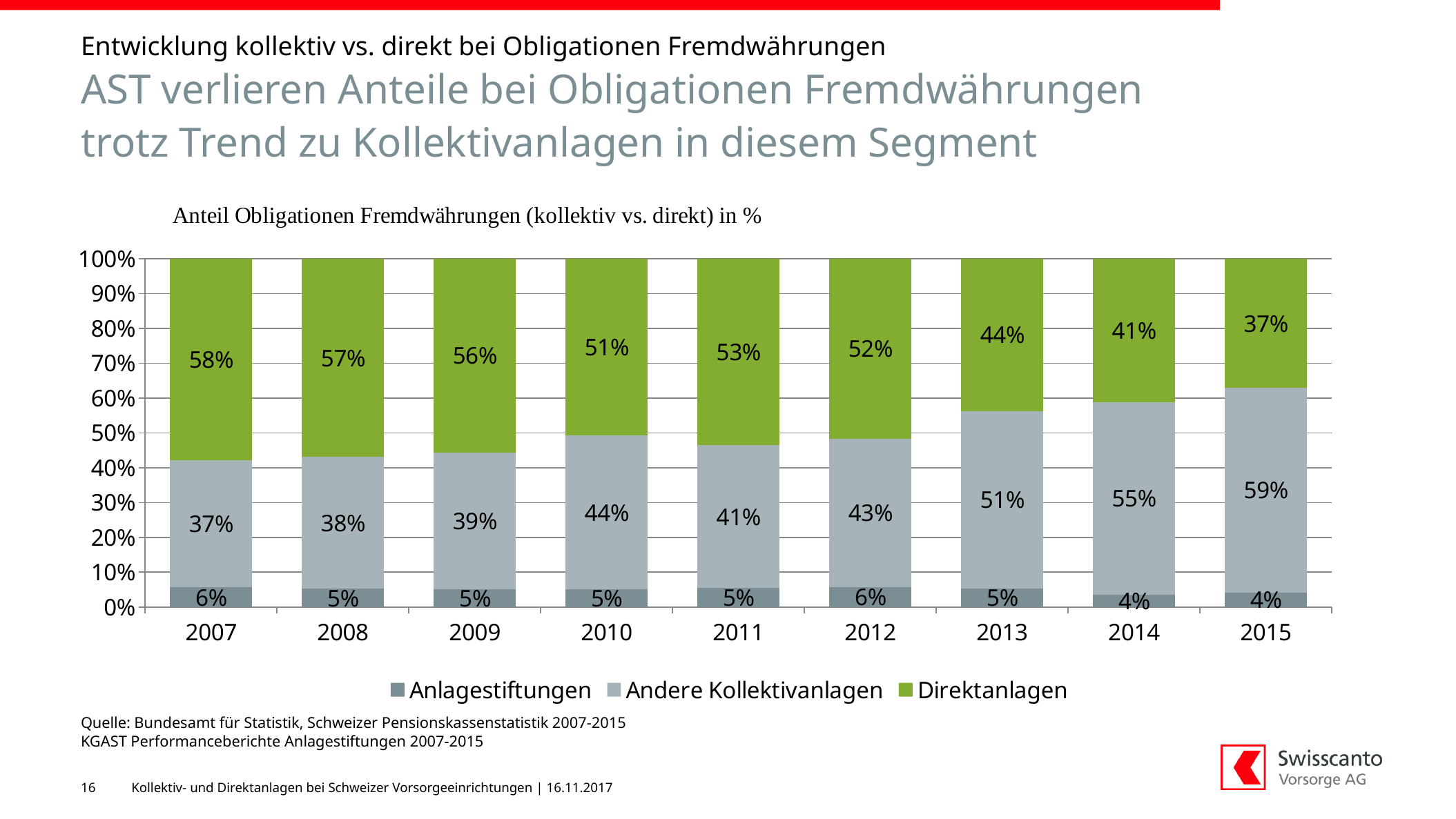
Does the Direktanlagen share rise or fall from 2007 to 2015? Fall What is the value for Andere Kollektivanlagen in 2014? 55% What is the value for Direktanlagen in 2010? 51% What is the difference between the Direktanlagen share in 2007 and in 2015? 21 percentage points In 2013, which is larger: Andere Kollektivanlagen or Direktanlagen? Andere Kollektivanlagen What is the value for Anlagestiftungen in 2012? 6% How many series does the chart's legend list? 3 How many years are shown on the x axis of the chart? 9 What is the title of the chart? Anteil Obligationen Fremdwährungen (kollektiv vs. direkt) in % In which year is the Andere Kollektivanlagen share lowest? 2007 What kind of chart is shown on the slide? Stacked bar chart In which year is the Direktanlagen share highest? 2007